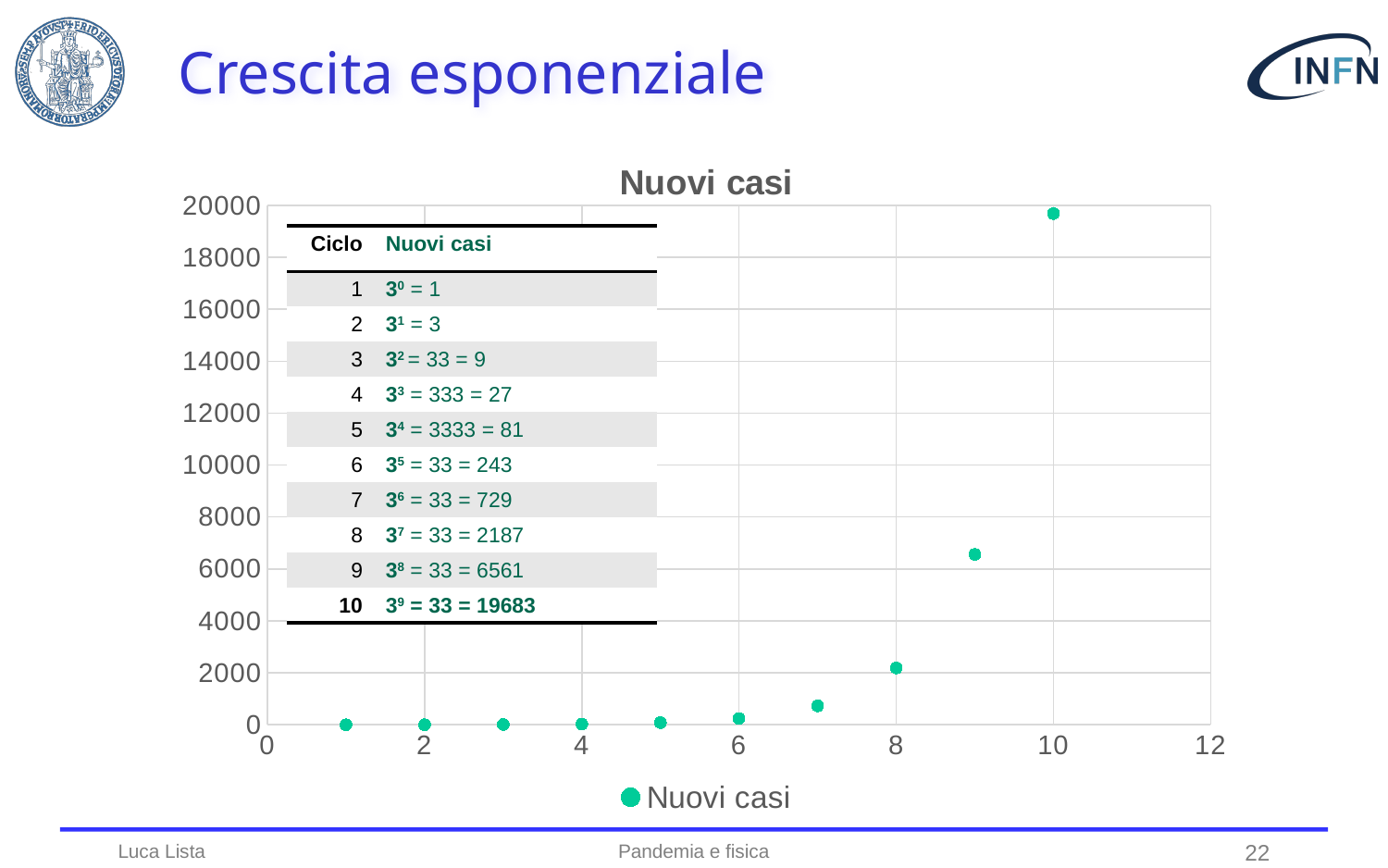
Is the value for ciclo 9 greater or less than 6000? greater Is the value for ciclo 8 greater or less than 4000? less Which is larger, the value at ciclo 9 or the value at ciclo 8? ciclo 9 At which ciclo is the value of Nuovi casi highest? 10 How many series does the legend list? 1 According to the table on the slide, what is the value of Nuovi casi at ciclo 8? 2187 Do the values rise or fall as the ciclo increases along the x axis? rise What is the title of the chart? Nuovi casi According to the table on the slide, what is the value of Nuovi casi at ciclo 10? 19683 According to the table on the slide, what is the value of Nuovi casi at ciclo 9? 6561 What kind of chart is shown on the slide? scatter chart How many data points are plotted in the chart? 10